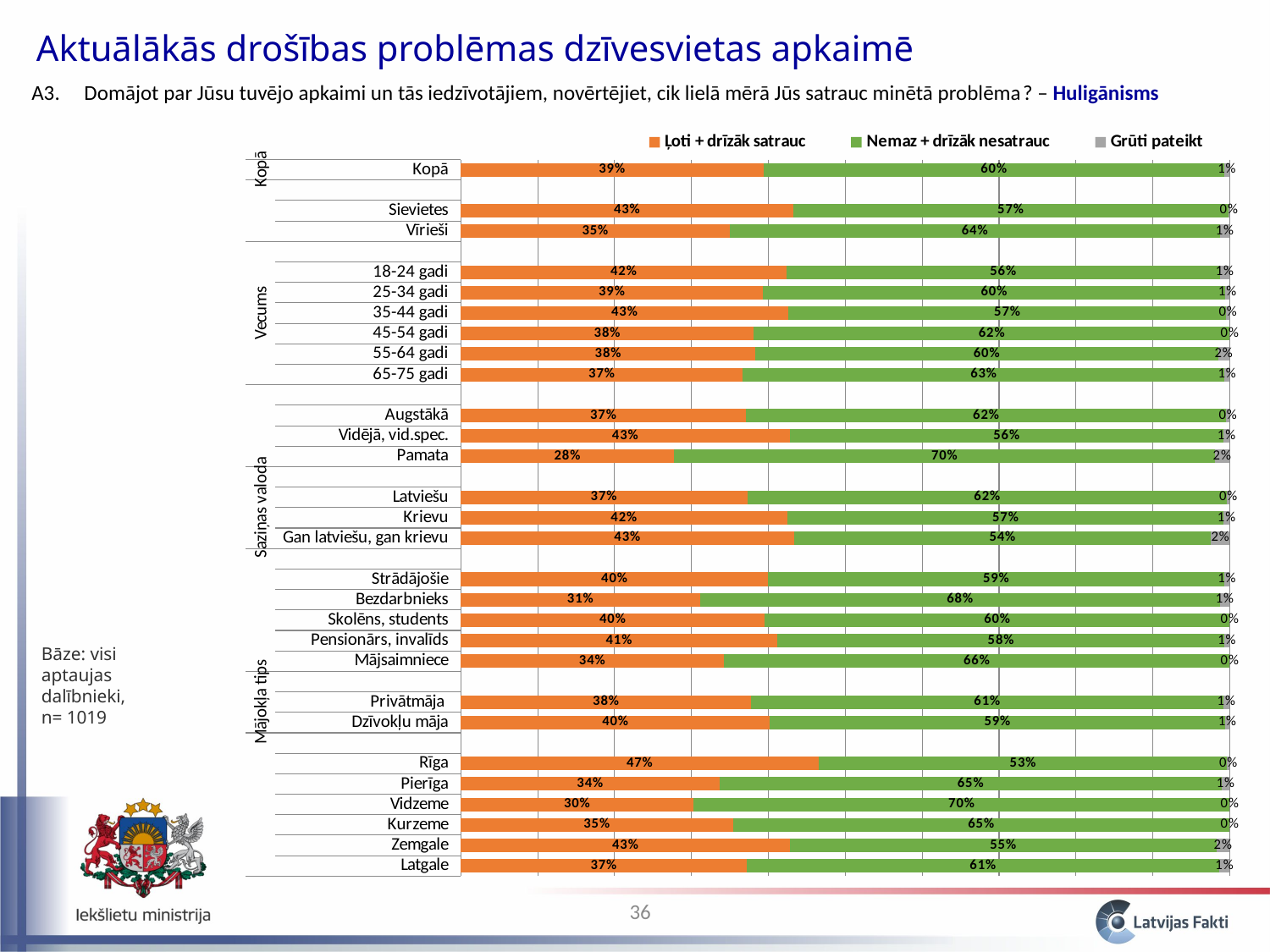
Which category has the highest value for "Ļoti + drīzāk satrauc"? Rīga What is the value of "Grūti pateikt" for Pamata? 2% Which category has the lowest value for "Ļoti + drīzāk satrauc"? Pamata Which colour represents the "Nemaz + drīzāk nesatrauc" series? Green What is the value of "Nemaz + drīzāk nesatrauc" for Vīrieši? 64% Which has a larger "Nemaz + drīzāk nesatrauc" value, Bezdarbnieks or Strādājošie? Bezdarbnieks How many series does the legend list? 3 What is the value of "Ļoti + drīzāk satrauc" for Kopā? 39% How many categories are plotted in the chart? 28 What is the total of the stacked bar for Zemgale? 100% What is the difference between the "Ļoti + drīzāk satrauc" values for Sievietes and Vīrieši? 8% What kind of chart is shown on the slide? Stacked bar chart